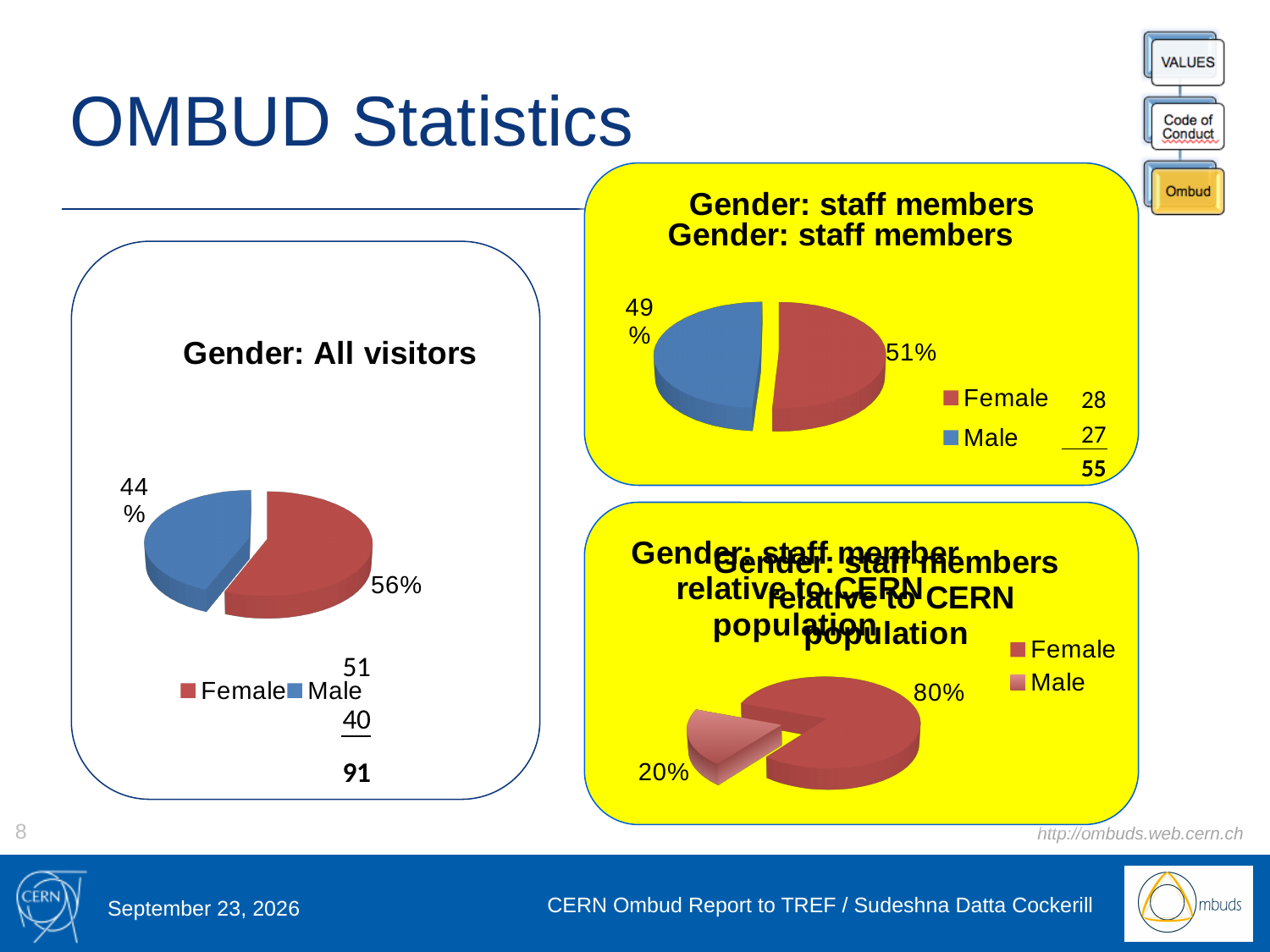
In the 'Gender: All visitors' pie chart, what percentage is shown for Male? 44% In the 'Gender: staff members' pie chart, what percentage is shown for Female? 51% How many entries does the legend of the 'Gender: staff members' chart list? 2 In the 'Gender: All visitors' pie chart, which category has the larger share? Female In the 'Gender: All visitors' pie chart, what is the difference in percentage points between the Female and Male shares? 12 What type of chart is used for 'Gender: All visitors'? Pie chart In the 'Gender: staff members relative to CERN population' pie chart, what percentage is shown for the larger slice? 80% In the 'Gender: staff members relative to CERN population' pie chart, what percentage is shown for the smaller slice? 20% In the 'Gender: All visitors' pie chart, what percentage is shown for Female? 56% In the 'Gender: staff members' pie chart, which category has the smaller share? Male In the 'Gender: staff members' pie chart, what percentage is shown for Male? 49% How many pie charts are shown on the slide? 3